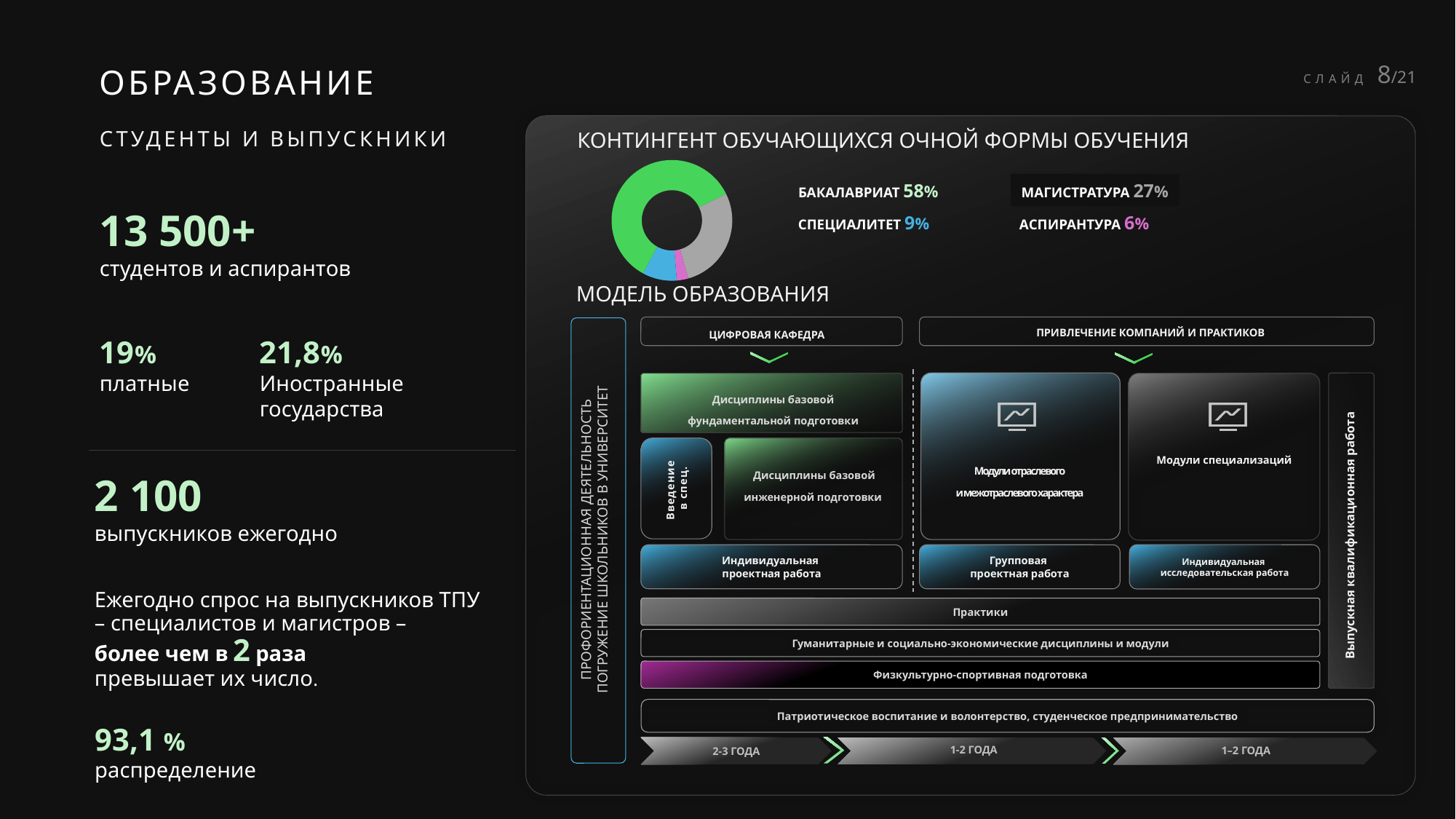
What share of the full-time student contingent is Бакалавриат? 58% What share of the full-time student contingent is Аспирантура? 6% What type of chart is shown under the title "КОНТИНГЕНТ ОБУЧАЮЩИХСЯ ОЧНОЙ ФОРМЫ ОБУЧЕНИЯ"? Pie (donut) chart Which category has the smallest share in the donut chart? Аспирантура What is the combined share of Специалитет and Аспирантура? 15% What is the difference in percentage points between Бакалавриат and Магистратура? 31 What colour represents Бакалавриат in the donut chart? Green What share of the full-time student contingent is Специалитет? 9% How many categories does the donut chart show? 4 What share of the full-time student contingent is Магистратура? 27% Which is larger in the donut chart: Специалитет or Аспирантура? Специалитет Which category has the largest share in the donut chart? Бакалавриат